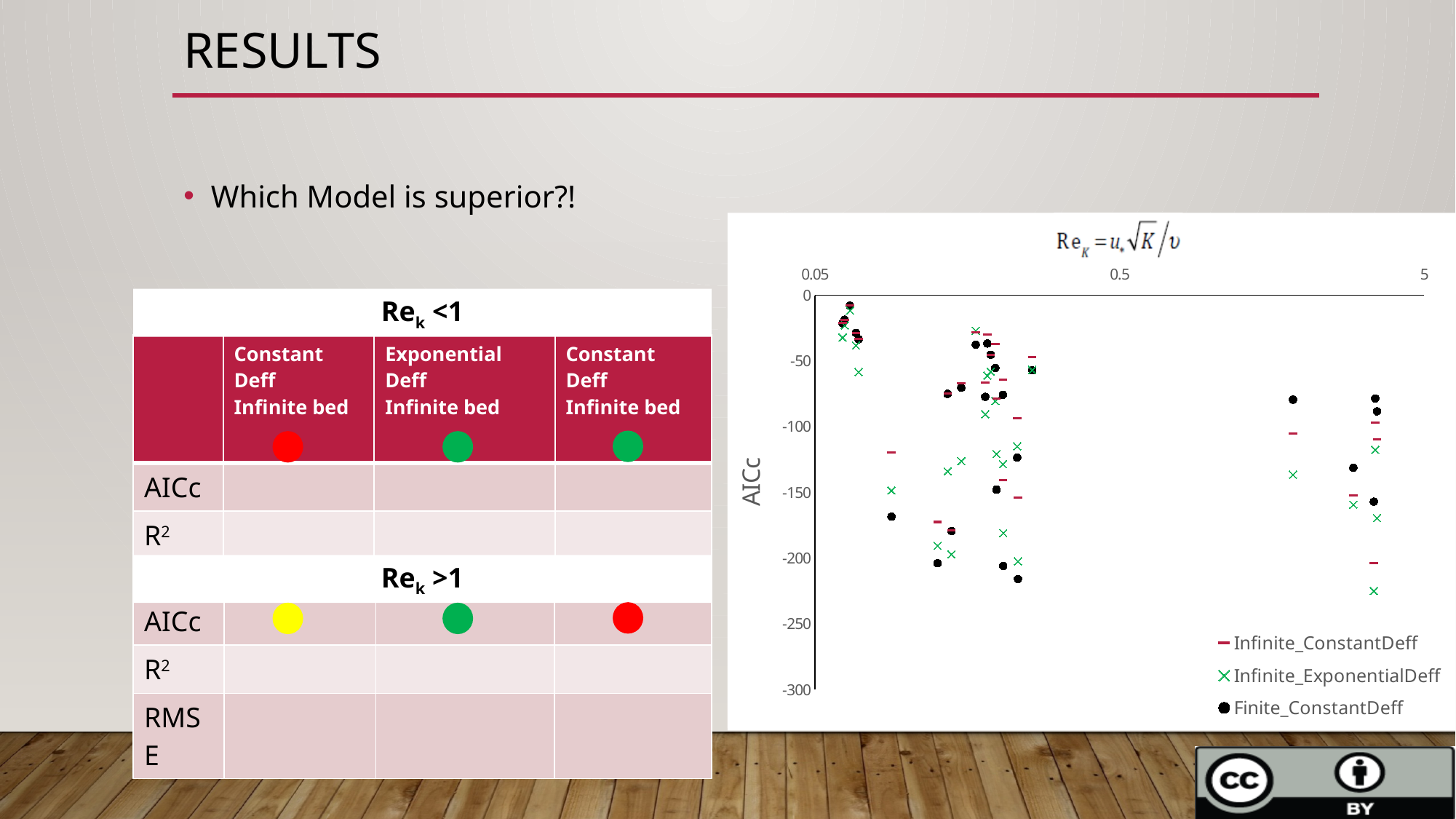
What kind of chart is shown on the slide? scatter chart What is the label on the chart's vertical axis? AICc What is the highest value shown on the chart's vertical axis? 0 Is the highest plotted point on the chart greater or less than 0? less How many series does the chart legend list? 3 Is the lowest Infinite_ExponentialDeff point on the chart greater or less than -200? less Is the highest Finite_ConstantDeff point on the chart greater or less than -50? greater What is the largest tick value shown on the chart's horizontal axis? 5 What are the three series named in the chart legend? Infinite_ConstantDeff, Infinite_ExponentialDeff, Finite_ConstantDeff Which series has the lowest plotted point on the chart? Infinite_ExponentialDeff How many tick labels are shown on the chart's horizontal axis? 3 What is the lowest value shown on the chart's vertical axis? -300